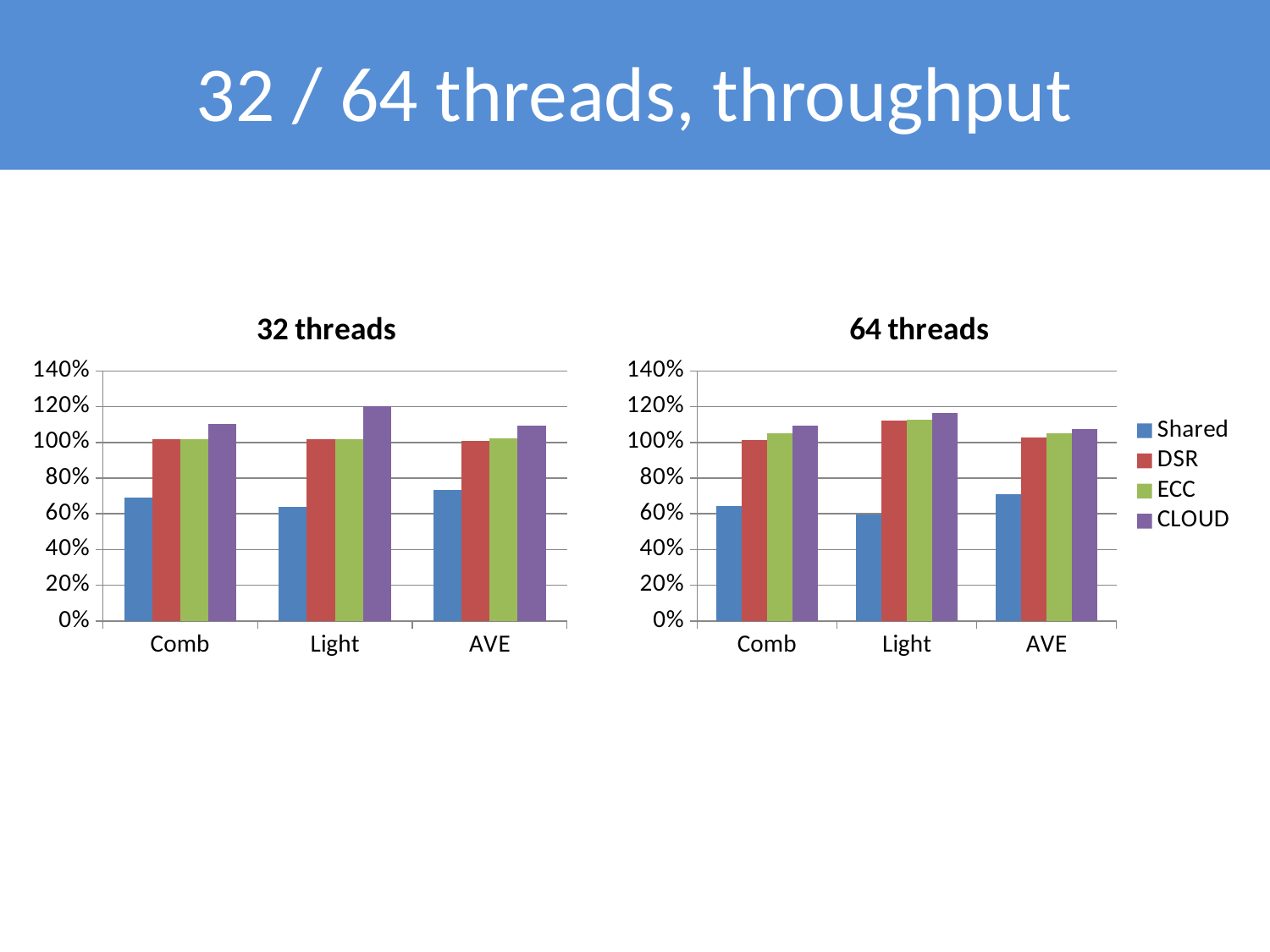
What kind of chart is the "32 threads" chart? bar chart In the "32 threads" chart, is the value for CLOUD in the Light category greater or less than 100%? greater In the "64 threads" chart, which series has the lowest bar in the Comb category? Shared How many series does the legend list for the charts on the slide? 4 In the "32 threads" chart, which category has the lowest Shared bar? Light In the "64 threads" chart, which is larger for the AVE category: Shared or DSR? DSR How many categories are shown on the x axis of the "64 threads" chart? 3 What is the title of the chart on the left of the slide? 32 threads In the "64 threads" chart, is the value for Shared in the Comb category greater or less than 80%? less In the "64 threads" chart, is the value for CLOUD in the Light category greater or less than 100%? greater In the "32 threads" chart, which series has the highest bar in the Light category? CLOUD